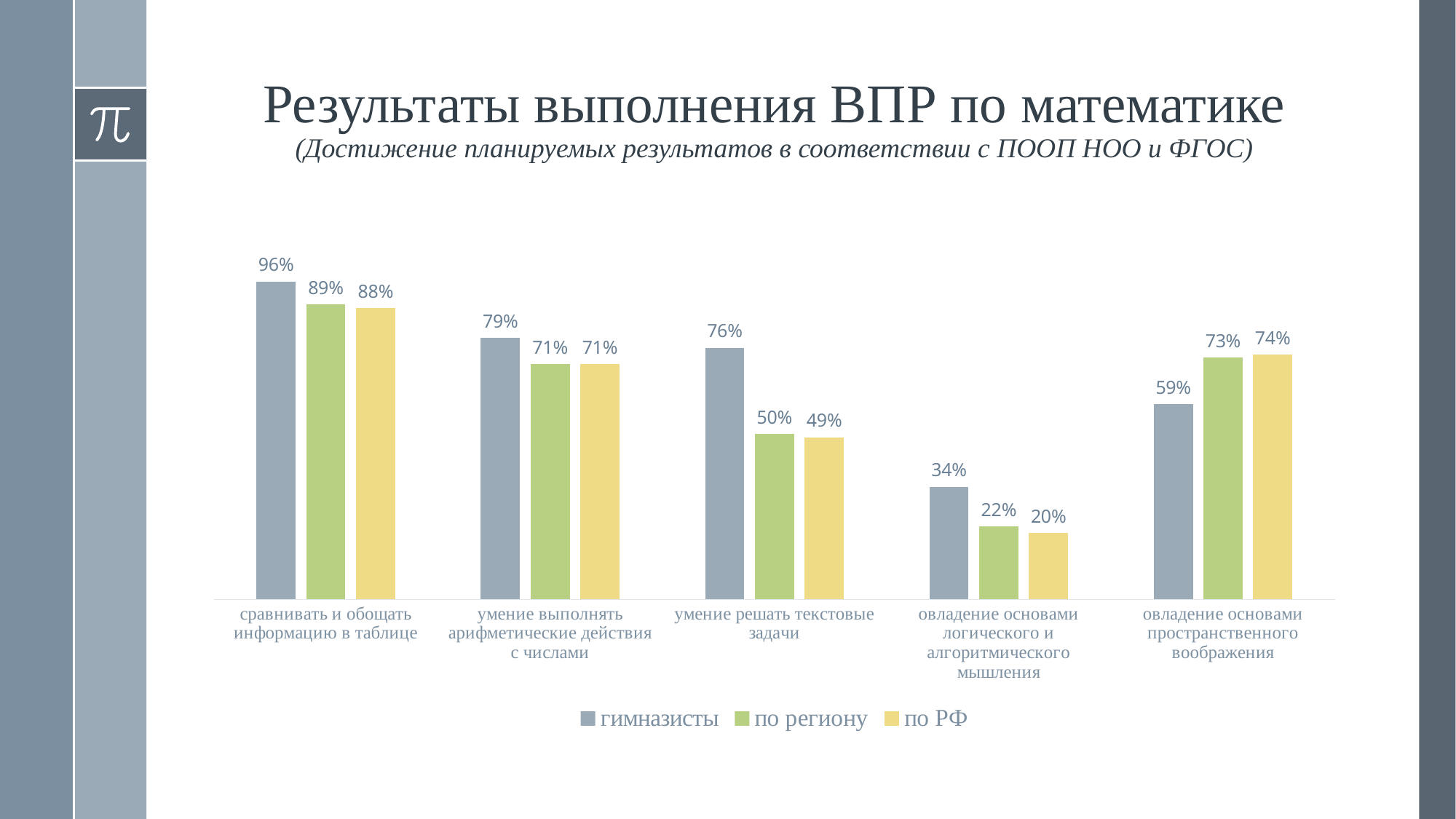
What is the value for по региону in the category «овладение основами логического и алгоритмического мышления»? 22% What is the difference between гимназисты and по РФ in the category «умение выполнять арифметические действия с числами»? 8% How many series does the legend list? 3 Which series is shown in yellow in the legend? по РФ What is the value for по РФ in the category «умение решать текстовые задачи»? 49% Which category has the highest value for по РФ? сравнивать и обощать информацию в таблице In the category «овладение основами пространственного воображения», which is larger: гимназисты or по РФ? по РФ Which category has the lowest value for гимназисты? овладение основами логического и алгоритмического мышления How many categories are shown on the x axis? 5 What is the value for гимназисты in the category «сравнивать и обощать информацию в таблице»? 96% What is the difference between гимназисты and по региону in the category «умение решать текстовые задачи»? 26% What kind of chart is shown on the slide? bar chart